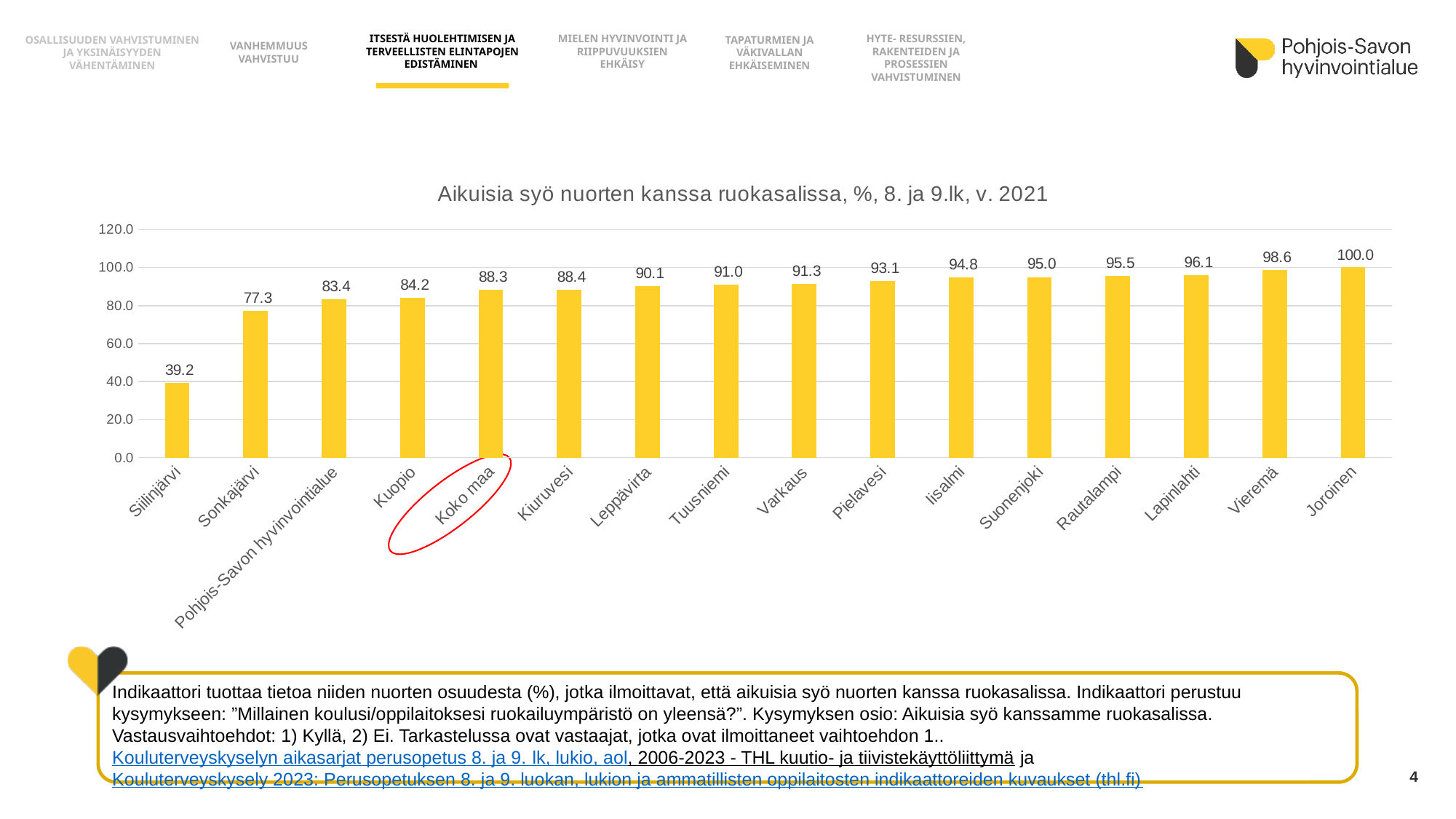
What is the value for Kuopio? 84.2 How many categories are shown on the x axis? 16 Which category has the lowest value? Siilinjärvi Which has a larger value, Sonkajärvi or Vieremä? Vieremä What is the difference between the values for Koko maa and Kuopio? 4.1 What is the value for Pohjois-Savon hyvinvointialue? 83.4 Is the value for Siilinjärvi greater or less than 60.0? less What is the title of the chart? Aikuisia syö nuorten kanssa ruokasalissa, %, 8. ja 9.lk, v. 2021 What is the difference between the values for Joroinen and Siilinjärvi? 60.8 What is the value for Koko maa? 88.3 What kind of chart is shown on the slide? bar chart Which category has the highest value? Joroinen